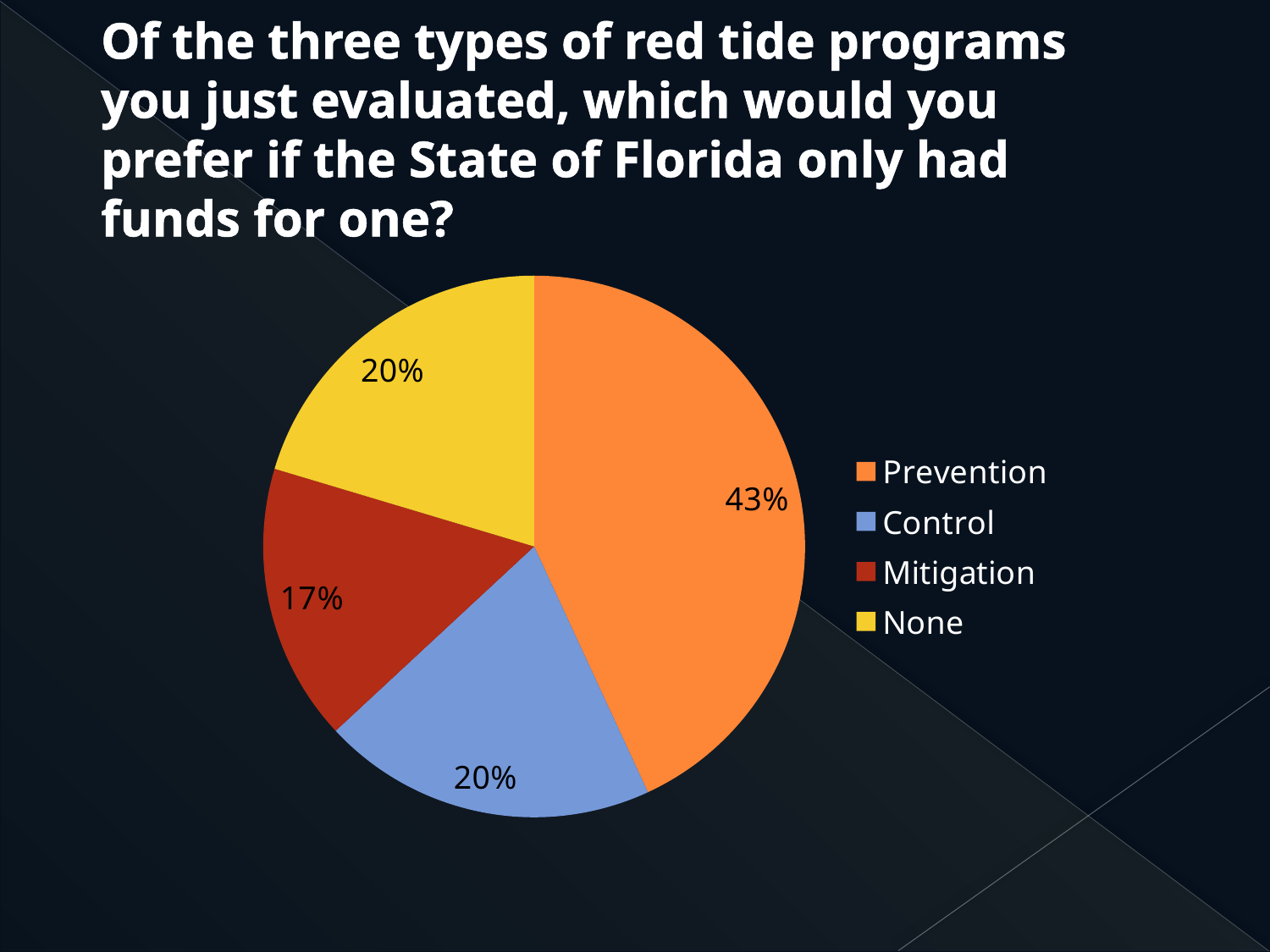
What is the difference in percentage points between Control and Mitigation? 3 What share of the pie does Mitigation have? 17% Which is larger, the Prevention slice or the Control slice? Prevention What share of the pie does Control have? 20% What share of the pie does Prevention have? 43% How many categories does the pie chart show? 4 Which category has the smallest slice of the pie? Mitigation What is the difference in percentage points between Prevention and Mitigation? 26 What colour is the Mitigation slice in the pie chart? red Which category has the largest slice of the pie? Prevention What kind of chart is shown on the slide? pie chart